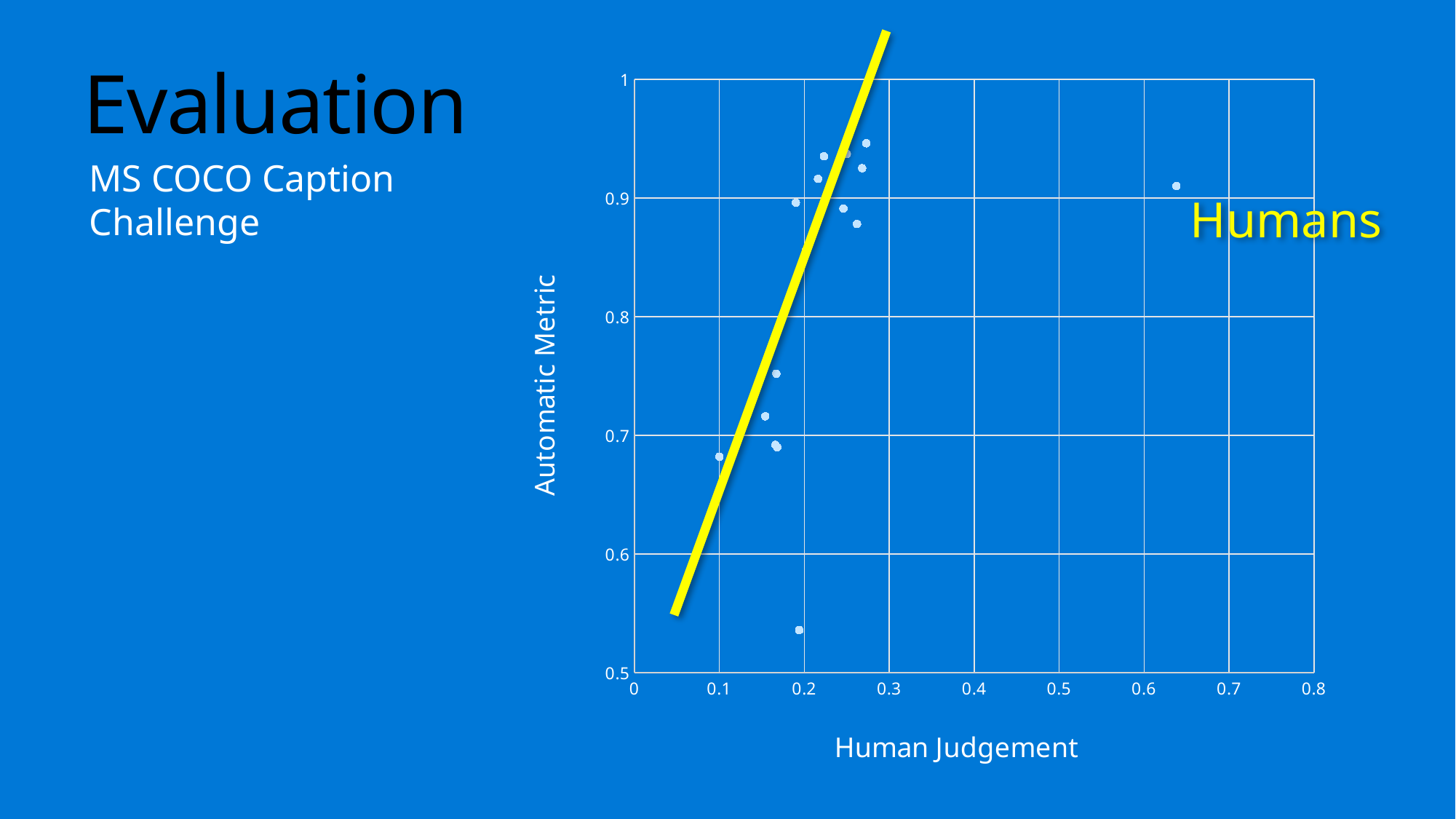
Which labelled point has the highest Human Judgement value? Humans What is the label of the vertical axis of the chart? Automatic Metric What is the highest value shown on the vertical axis of the chart? 1 Do the Automatic Metric values generally rise or fall as Human Judgement increases, according to the yellow trend line? rise Is the Human Judgement value for the point labelled "Humans" greater or less than 0.6? greater What kind of chart is shown on the slide? scatter chart Is the Human Judgement value for the point labelled "Humans" greater or less than 0.7? less Is the Automatic Metric value for the point labelled "Humans" greater or less than 0.9? greater What is the label of the horizontal axis of the chart? Human Judgement